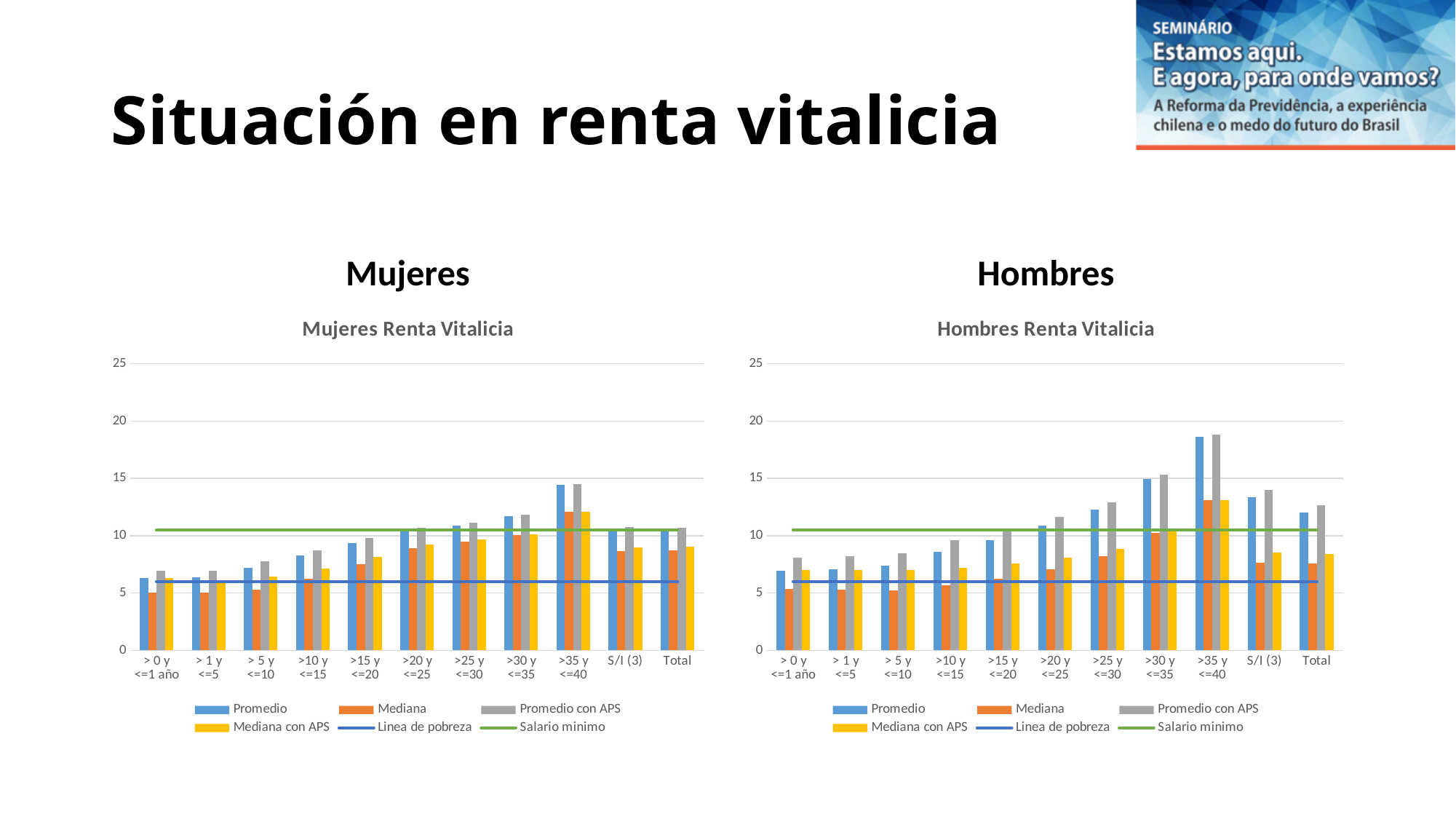
How many series does the legend of the Mujeres Renta Vitalicia chart list? 6 In the Mujeres Renta Vitalicia chart, which category has the highest Promedio value? >35 y <=40 Which legend entry in the Mujeres Renta Vitalicia chart is drawn as a green line? Salario minimo What kind of chart is the Mujeres Renta Vitalicia chart? combination bar and line chart In the Hombres Renta Vitalicia chart, which is larger: the Promedio value for >30 y <=35 or for >25 y <=30? >30 y <=35 In the Mujeres Renta Vitalicia chart, which is larger: the Promedio value for >35 y <=40 or for Total? >35 y <=40 In the Mujeres Renta Vitalicia chart, is the Promedio con APS value for >35 y <=40 greater or less than 10? greater In the Hombres Renta Vitalicia chart, is the Mediana value for >35 y <=40 greater or less than 10? greater How many categories are shown on the x axis of the Hombres Renta Vitalicia chart? 11 In the Hombres Renta Vitalicia chart, is the Promedio value for >35 y <=40 greater or less than 15? greater In the Hombres Renta Vitalicia chart, which category has the highest Promedio value? >35 y <=40 In the Hombres Renta Vitalicia chart, do the Promedio values generally rise or fall from >0 y <=1 año to >35 y <=40? rise